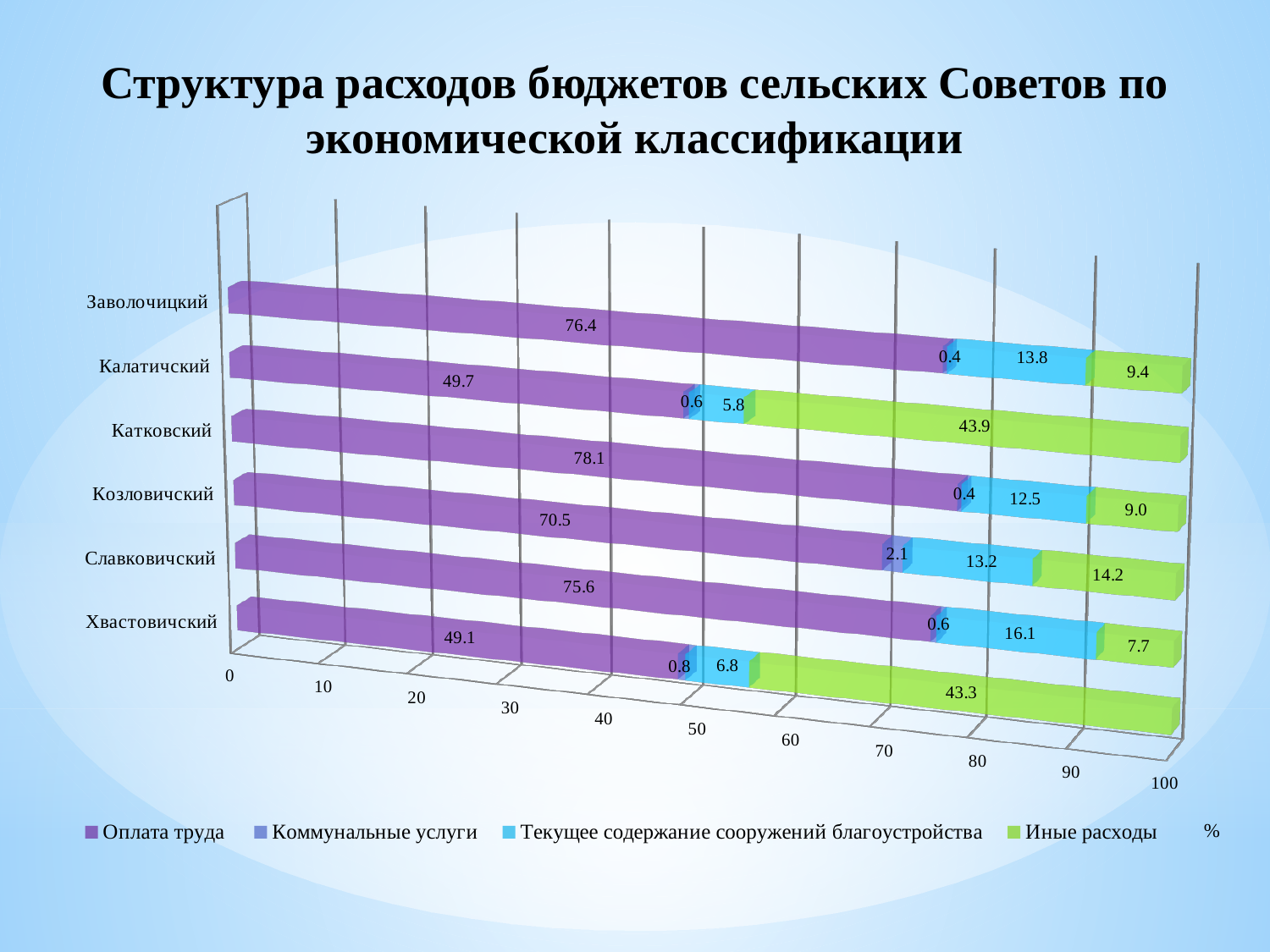
What is the value of Иные расходы for Калатичский? 43.9 Which category has the lowest value for Иные расходы? Славковичский What is the value of Оплата труда for Заволочицкий? 76.4 Which category has the highest value for Оплата труда? Катковский What is the value of Коммунальные услуги for Козловичский? 2.1 How many series does the legend list? 4 What is the difference between the Оплата труда values for Катковский and Хвастовичский? 29.0 Which is larger: Иные расходы for Калатичский or for Хвастовичский? Калатичский What kind of chart is shown on the slide? Stacked bar chart How many categories are shown on the chart? 6 What is the value of Текущее содержание сооружений благоустройства for Славковичский? 16.1 What is the total of the stacked bar for Козловичский? 100.0